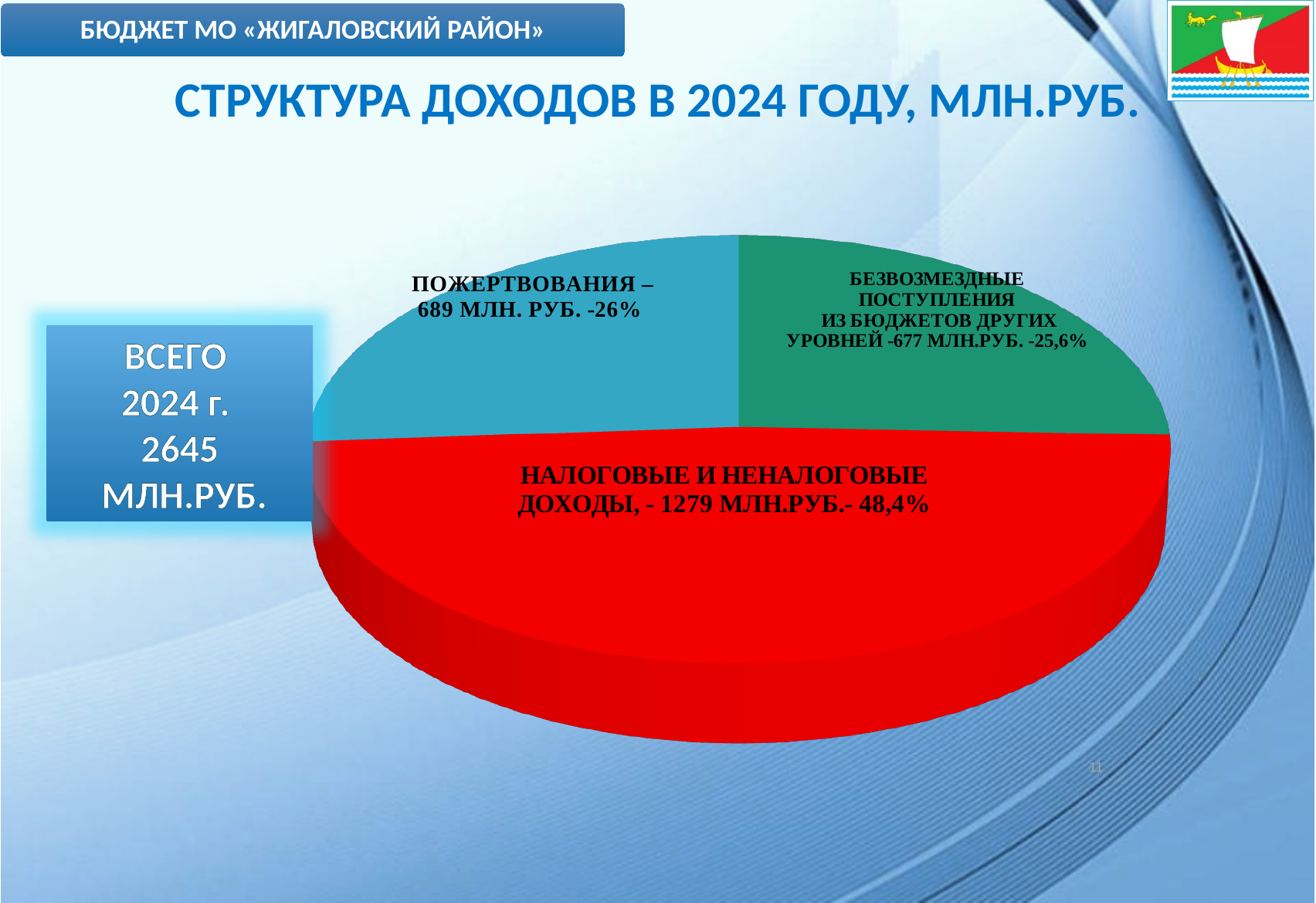
What is the total of all slices in the pie chart, as shown on the slide? 2645 МЛН.РУБ. What kind of chart is shown on the slide? pie chart How many slices does the pie chart have? 3 What is the difference between НАЛОГОВЫЕ И НЕНАЛОГОВЫЕ ДОХОДЫ and ПОЖЕРТВОВАНИЯ in млн.руб.? 590 What share of the pie does БЕЗВОЗМЕЗДНЫЕ ПОСТУПЛЕНИЯ ИЗ БЮДЖЕТОВ ДРУГИХ УРОВНЕЙ represent? 25,6% What is the value for БЕЗВОЗМЕЗДНЫЕ ПОСТУПЛЕНИЯ ИЗ БЮДЖЕТОВ ДРУГИХ УРОВНЕЙ? 677 МЛН.РУБ. What is the value for ПОЖЕРТВОВАНИЯ? 689 МЛН. РУБ. Which category has the largest slice of the pie? НАЛОГОВЫЕ И НЕНАЛОГОВЫЕ ДОХОДЫ Which category has the smallest slice of the pie? БЕЗВОЗМЕЗДНЫЕ ПОСТУПЛЕНИЯ ИЗ БЮДЖЕТОВ ДРУГИХ УРОВНЕЙ Which is larger, ПОЖЕРТВОВАНИЯ or БЕЗВОЗМЕЗДНЫЕ ПОСТУПЛЕНИЯ ИЗ БЮДЖЕТОВ ДРУГИХ УРОВНЕЙ? ПОЖЕРТВОВАНИЯ What is the value for НАЛОГОВЫЕ И НЕНАЛОГОВЫЕ ДОХОДЫ? 1279 МЛН.РУБ. What share of the pie does НАЛОГОВЫЕ И НЕНАЛОГОВЫЕ ДОХОДЫ represent? 48,4%